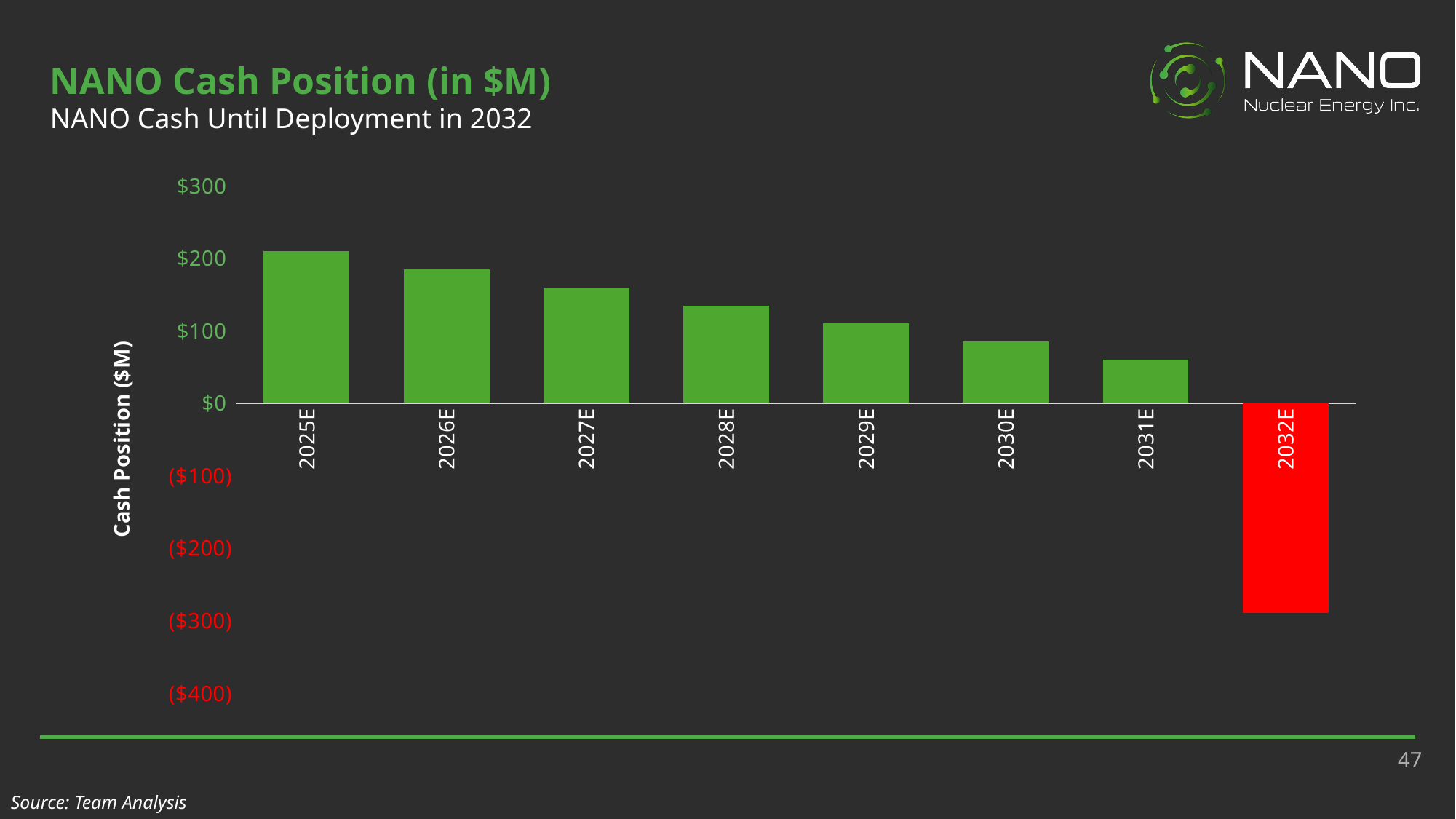
Is the cash position for 2032E greater or less than ($200)? less What kind of chart is shown on the slide? bar chart Is the cash position for 2028E greater or less than $100? greater Do the cash position values rise or fall from 2025E to 2031E? fall Which year has the highest cash position? 2025E How many years are plotted on the chart? 8 Which year has the lowest cash position? 2032E Is the cash position for 2025E greater or less than $200? greater What is the title of the chart? NANO Cash Position (in $M) What colour is the bar for 2032E? red Which year has a larger cash position, 2026E or 2029E? 2026E